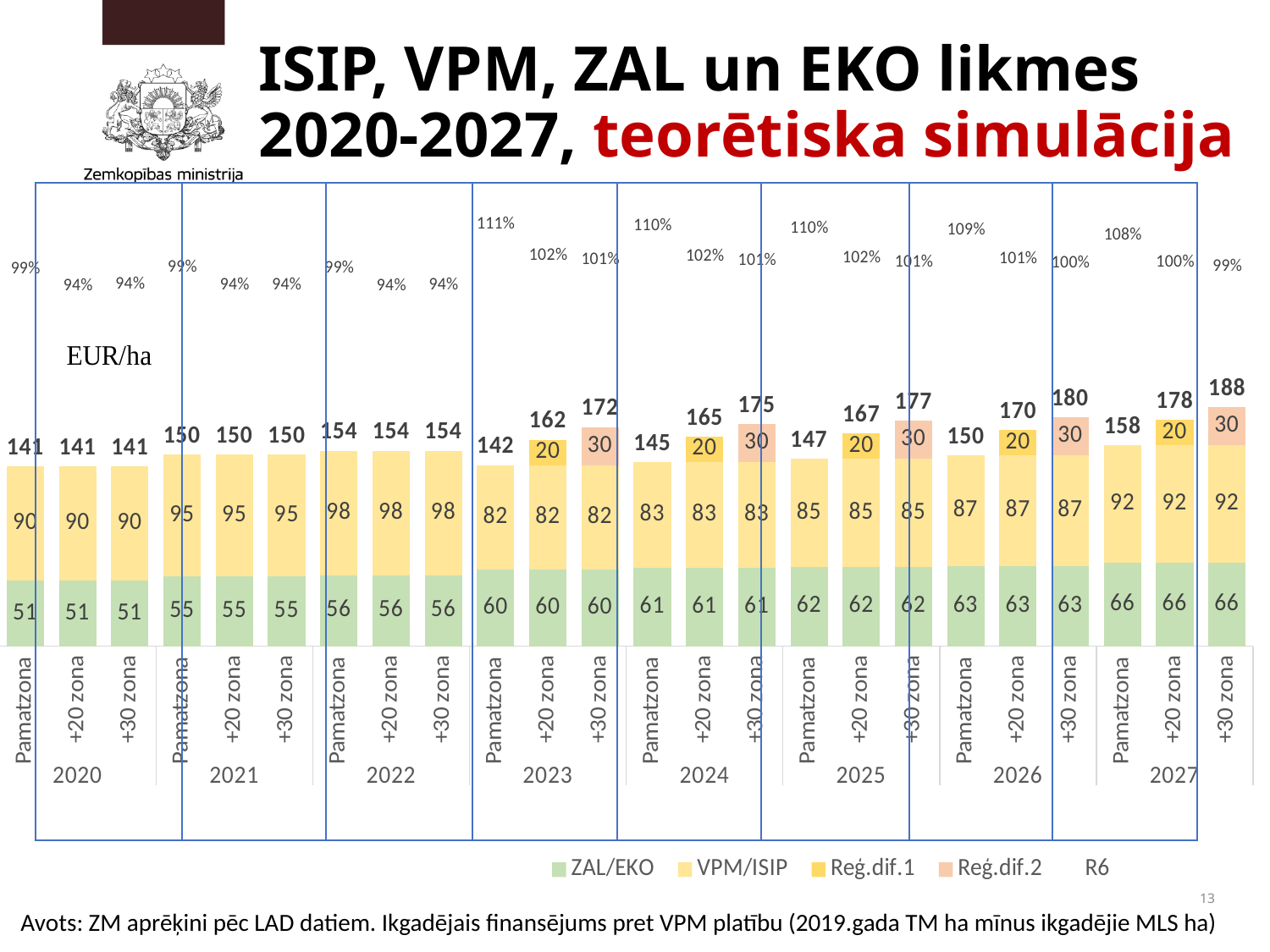
What kind of chart is shown on the slide? Stacked bar chart How many series does the legend list? 5 Which is larger: the ZAL/EKO value for Pamatzona in 2022 or for Pamatzona in 2025? Pamatzona in 2025 What is the Reģ.dif.2 value for +30 zona in 2023? 30 What is the total printed above the +30 zona bar in 2027? 188 Do the ZAL/EKO values for Pamatzona rise or fall from 2020 to 2027? Rise What is the difference between the totals of the +30 zona bar and the Pamatzona bar in 2024? 30 What is the ZAL/EKO value for Pamatzona in 2020? 51 Which bar has the highest total value? +30 zona 2027 What is the total of the +20 zona bar in 2026? 170 What unit is shown on the chart? EUR/ha What is the VPM/ISIP value for +20 zona in 2027? 92